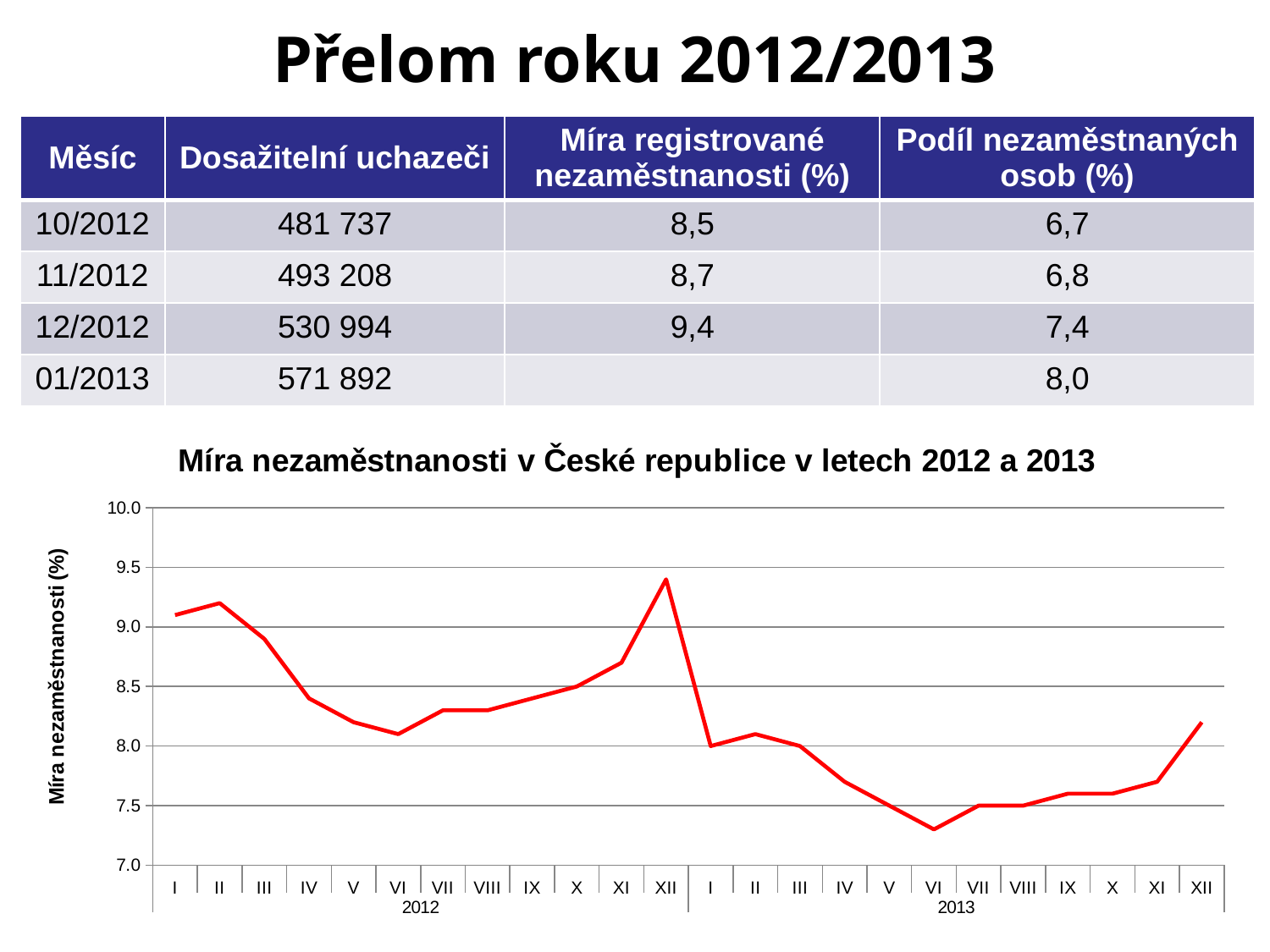
How many monthly data points are plotted on the chart? 24 In which month is the unemployment rate on the chart lowest? VI 2013 Which is larger, the value for XII 2012 or the value for XII 2013? XII 2012 What is the title of the chart? Míra nezaměstnanosti v České republice v letech 2012 a 2013 Is the value for IV 2013 greater or less than 8.0? less In which month is the unemployment rate on the chart highest? XII 2012 What kind of chart is shown on the slide? line chart Is the value for XII 2012 greater or less than 9.0? greater What is the label of the vertical axis of the chart? Míra nezaměstnanosti (%) Is the value for VI 2012 greater or less than 8.5? less Does the unemployment rate rise or fall from I 2012 to VI 2012? fall